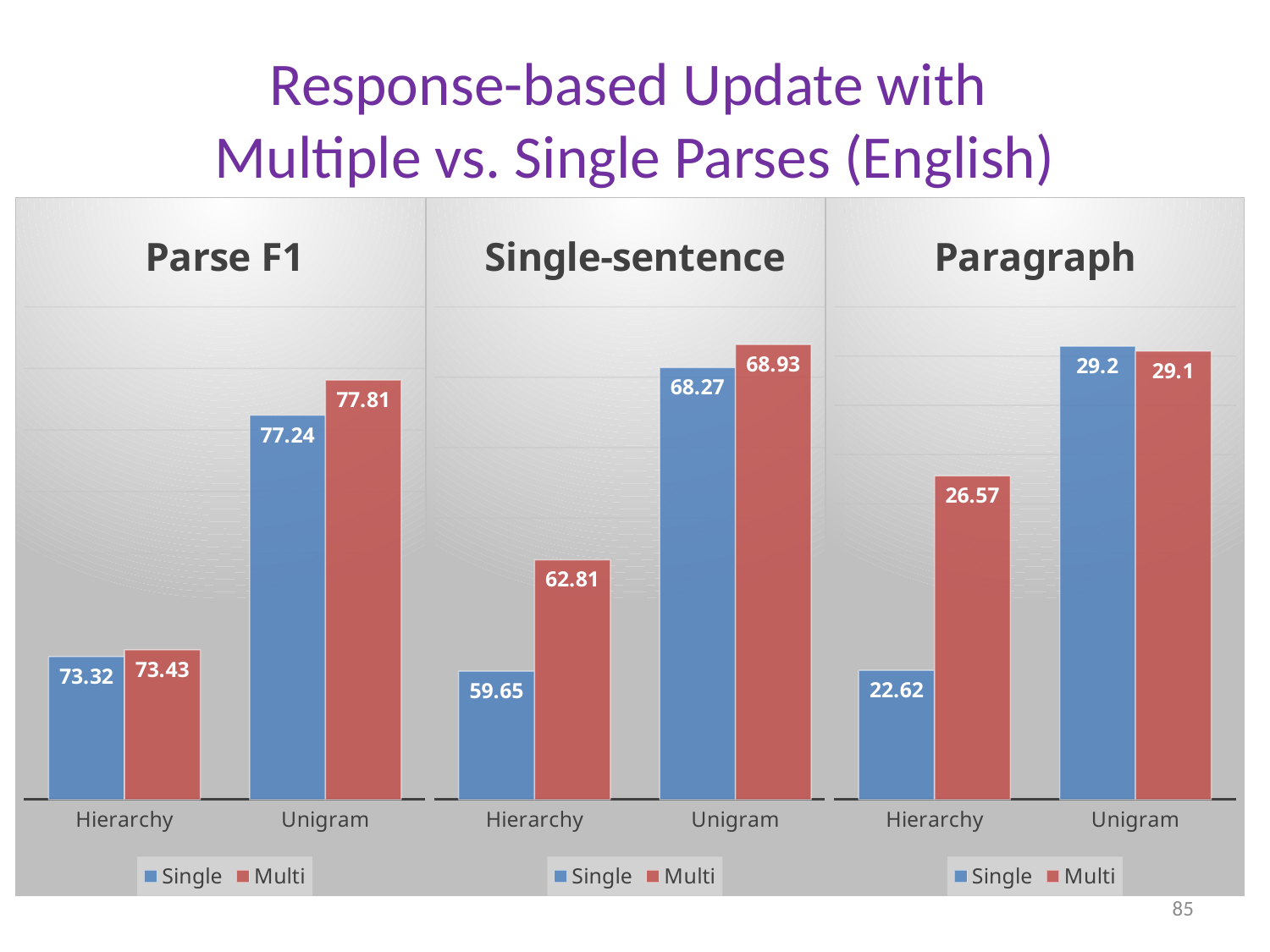
How many series does the legend of the Paragraph chart list? 2 In the Parse F1 chart, what is the value for Single on Unigram? 77.24 In the Single-sentence chart, which bar has the lowest value? Single on Hierarchy In the Single-sentence chart, what is the difference between Multi and Single on Hierarchy? 3.16 In the Paragraph chart, what is the value for Single on Hierarchy? 22.62 In the Single-sentence chart, what is the value for Multi on Hierarchy? 62.81 How many categories are shown on the x axis of the Single-sentence chart? 2 In the Parse F1 chart, which bar has the highest value? Multi on Unigram In the Paragraph chart, what is the value for Multi on Unigram? 29.1 What kind of chart is the Parse F1 chart? Bar chart In the Parse F1 chart, what is the difference between Multi and Single on Unigram? 0.57 In the Paragraph chart, which is larger on Hierarchy, Single or Multi? Multi